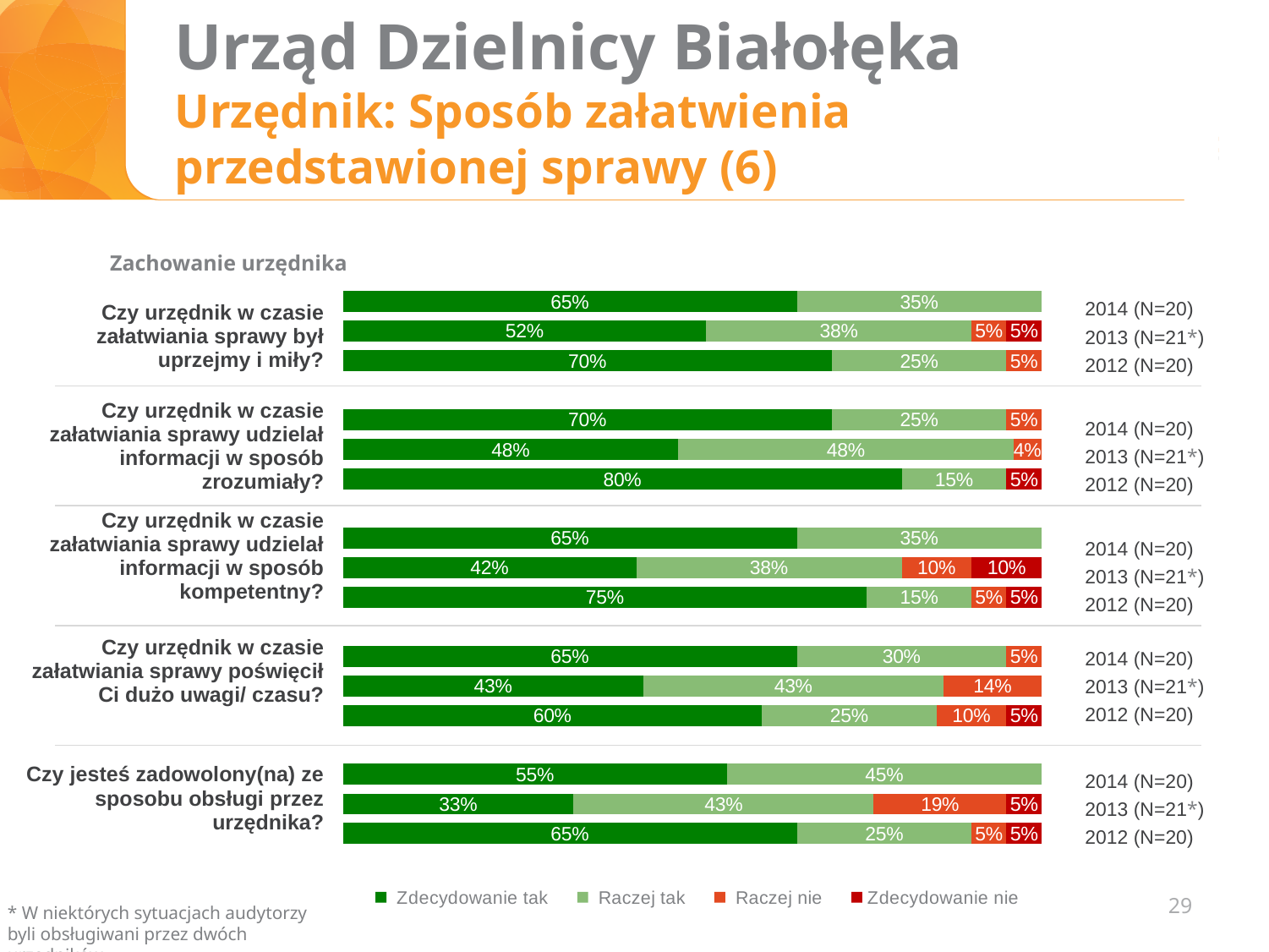
For "Czy jesteś zadowolony(na) ze sposobu obsługi przez urzędnika?", was the "Raczej tak" share larger in 2014 or in 2012? 2014 What is the sample size shown for the 2013 bars? N=21* What percentage answered "Zdecydowanie nie" in 2013 to "Czy urzędnik w czasie załatwiania sprawy udzielał informacji w sposób kompetentny?"? 10% What percentage answered "Raczej tak" in 2013 to "Czy urzędnik w czasie załatwiania sprawy udzielał informacji w sposób zrozumiały?"? 48% For "Czy urzędnik w czasie załatwiania sprawy udzielał informacji w sposób zrozumiały?", which year had the highest share of "Zdecydowanie tak"? 2012 What percentage answered "Raczej nie" in 2013 to "Czy jesteś zadowolony(na) ze sposobu obsługi przez urzędnika?"? 19% How many survey questions are shown in the chart? 5 How many response categories does the legend list? 4 What kind of chart is shown on the slide? Stacked bar chart For "Czy urzędnik w czasie załatwiania sprawy poświęcił Ci dużo uwagi/ czasu?", how many percentage points higher was "Zdecydowanie tak" in 2014 than in 2013? 22 percentage points For "Czy jesteś zadowolony(na) ze sposobu obsługi przez urzędnika?", which year had the lowest share of "Zdecydowanie tak"? 2013 What percentage answered "Zdecydowanie tak" in 2014 to "Czy urzędnik w czasie załatwiania sprawy był uprzejmy i miły?"? 65%